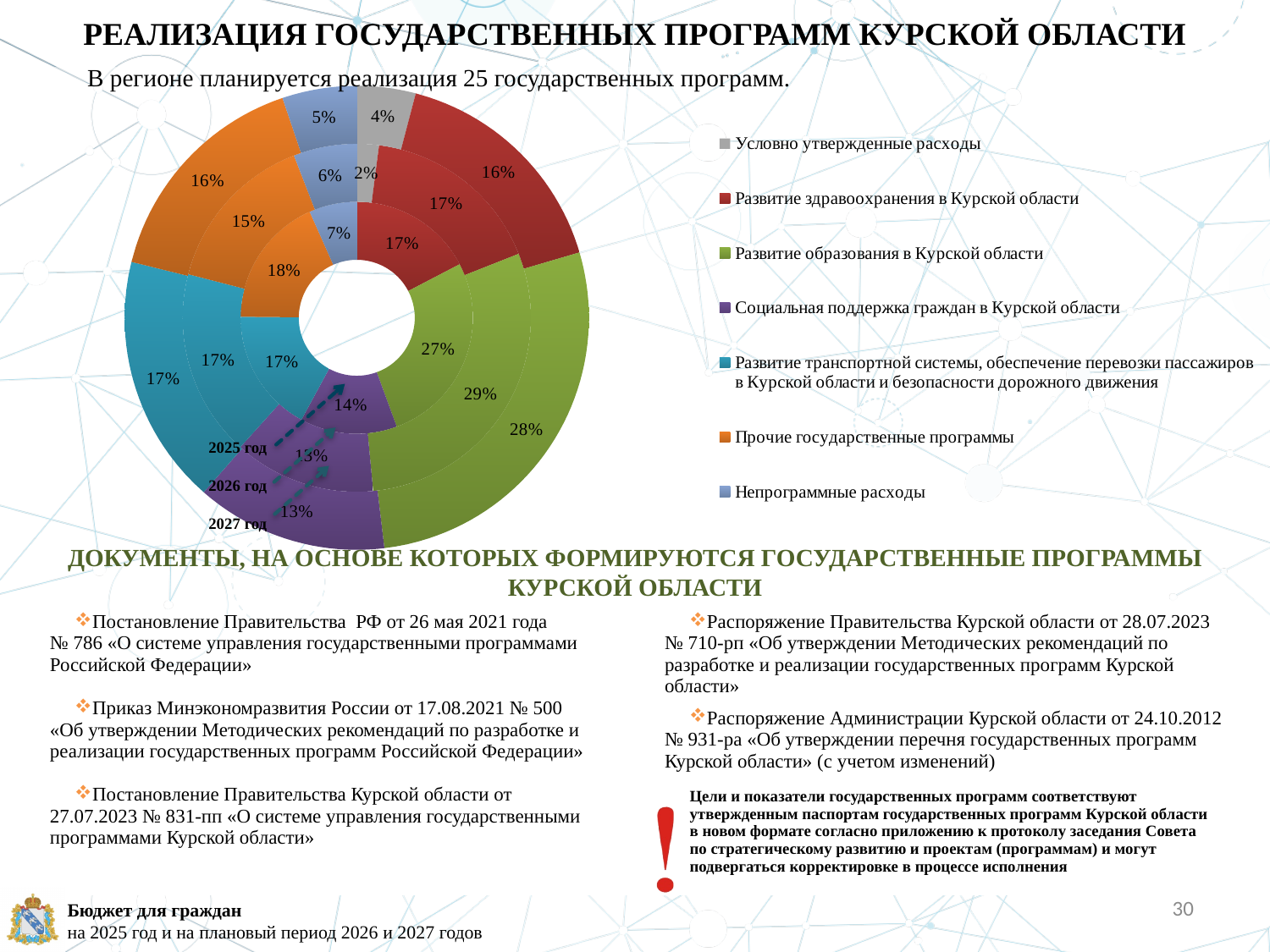
What share does "Непрограммные расходы" have in the 2025 ring? 7% What share does "Социальная поддержка граждан в Курской области" have in the 2025 ring? 14% What share does "Развитие образования в Курской области" have in the 2025 ring (innermost)? 27% What kind of chart is shown on the slide? doughnut chart What share does "Развитие здравоохранения в Курской области" have in the 2025 ring? 17% In the 2026 ring, what is the difference between the share of "Развитие образования" (29%) and "Социальная поддержка граждан" (13%)? 16 percentage points What share does "Прочие государственные программы" have in the 2025 ring? 18% What colour represents "Развитие здравоохранения в Курской области" in the legend? red Does the share of "Непрограммные расходы" rise or fall from the 2025 ring to the 2027 ring? fall Which program has the largest share in the 2025 ring? Развитие образования в Курской области How many entries does the chart legend list? 7 What share does "Развитие образования в Курской области" have in the 2027 ring (outermost)? 28%